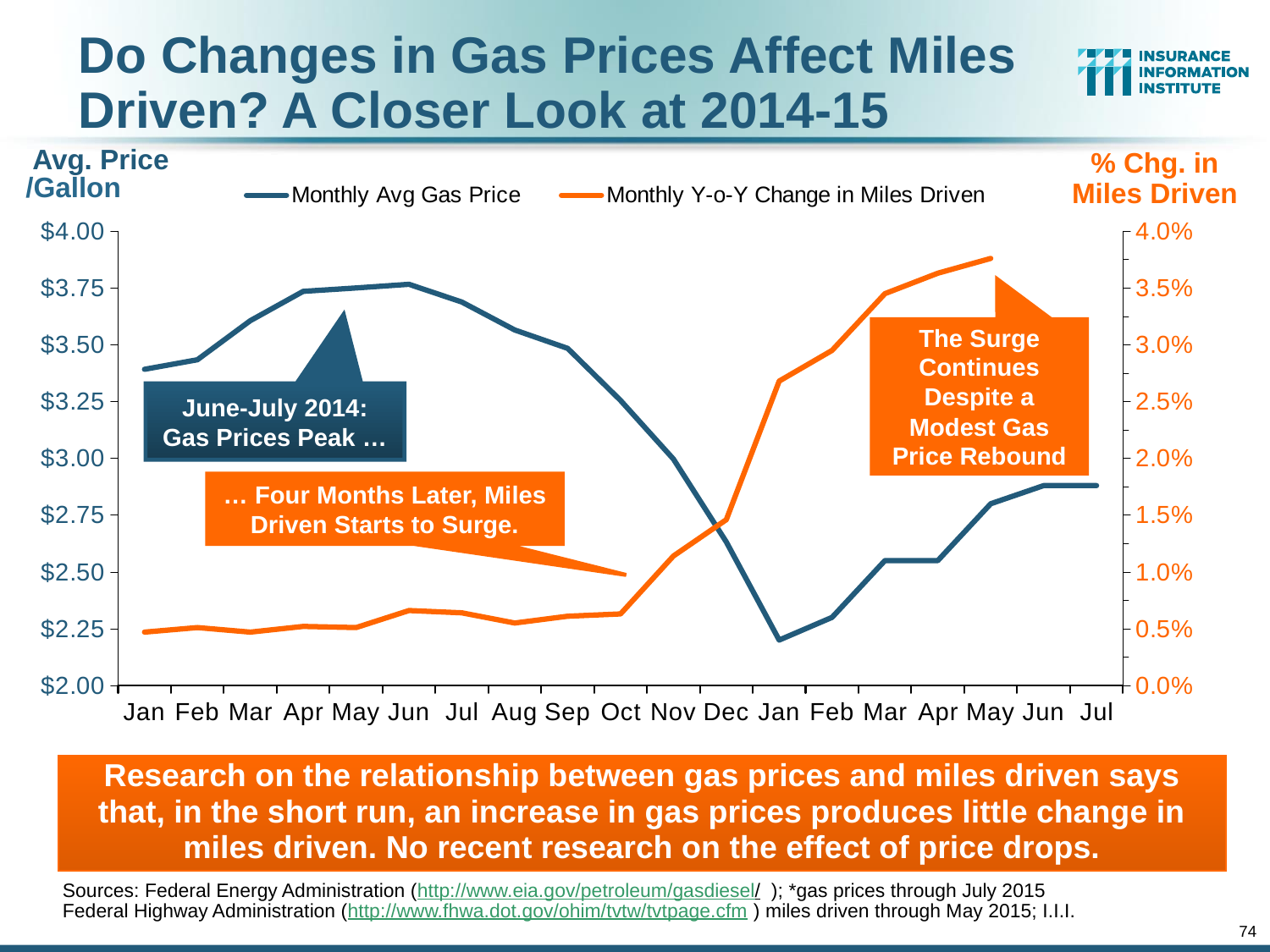
How many months are labelled on the x axis? 19 Is the Monthly Avg Gas Price for the first Jun on the x axis (Jun 2014) greater or less than $3.50? greater What kind of chart is shown on the slide? Line chart In which month is the Monthly Y-o-Y Change in Miles Driven highest? May (2015) How many series does the legend list? 2 Is the Monthly Y-o-Y Change in Miles Driven for Oct greater or less than 1.0%? less Does the Monthly Avg Gas Price rise or fall from Jun 2014 to Jan 2015? Fall Is the Monthly Avg Gas Price for the second Jan on the x axis (Jan 2015) greater or less than $2.50? less Which is higher, the Monthly Avg Gas Price in the first Jan (Jan 2014) or in the second Jan (Jan 2015)? Jan 2014 What are the two series named in the legend? Monthly Avg Gas Price; Monthly Y-o-Y Change in Miles Driven In which month is the Monthly Avg Gas Price lowest? Jan (2015)